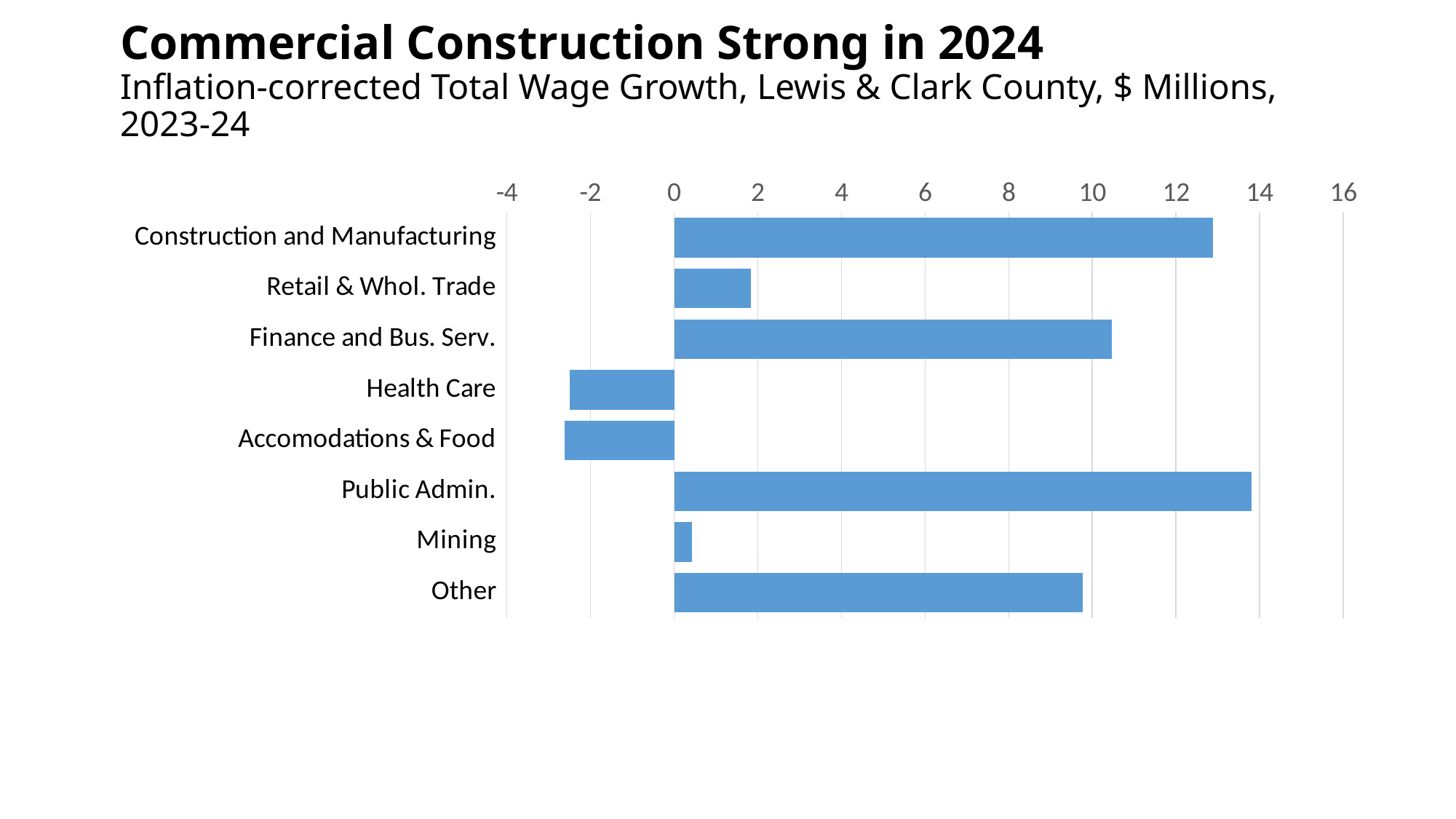
What kind of chart is shown on the slide? bar chart What is the title of the slide? Commercial Construction Strong in 2024 Which is larger, the value for Retail & Whol. Trade or the value for Mining? Retail & Whol. Trade How many industry categories are plotted in the chart? 8 Which category has the highest inflation-corrected total wage growth? Public Admin. Is the value for Health Care greater or less than 0? less How many categories show negative wage growth in the chart? 2 Is the value for Retail & Whol. Trade greater or less than 2? less Is the value for Other greater or less than 10? less Which is larger, the value for Construction and Manufacturing or the value for Finance and Bus. Serv.? Construction and Manufacturing